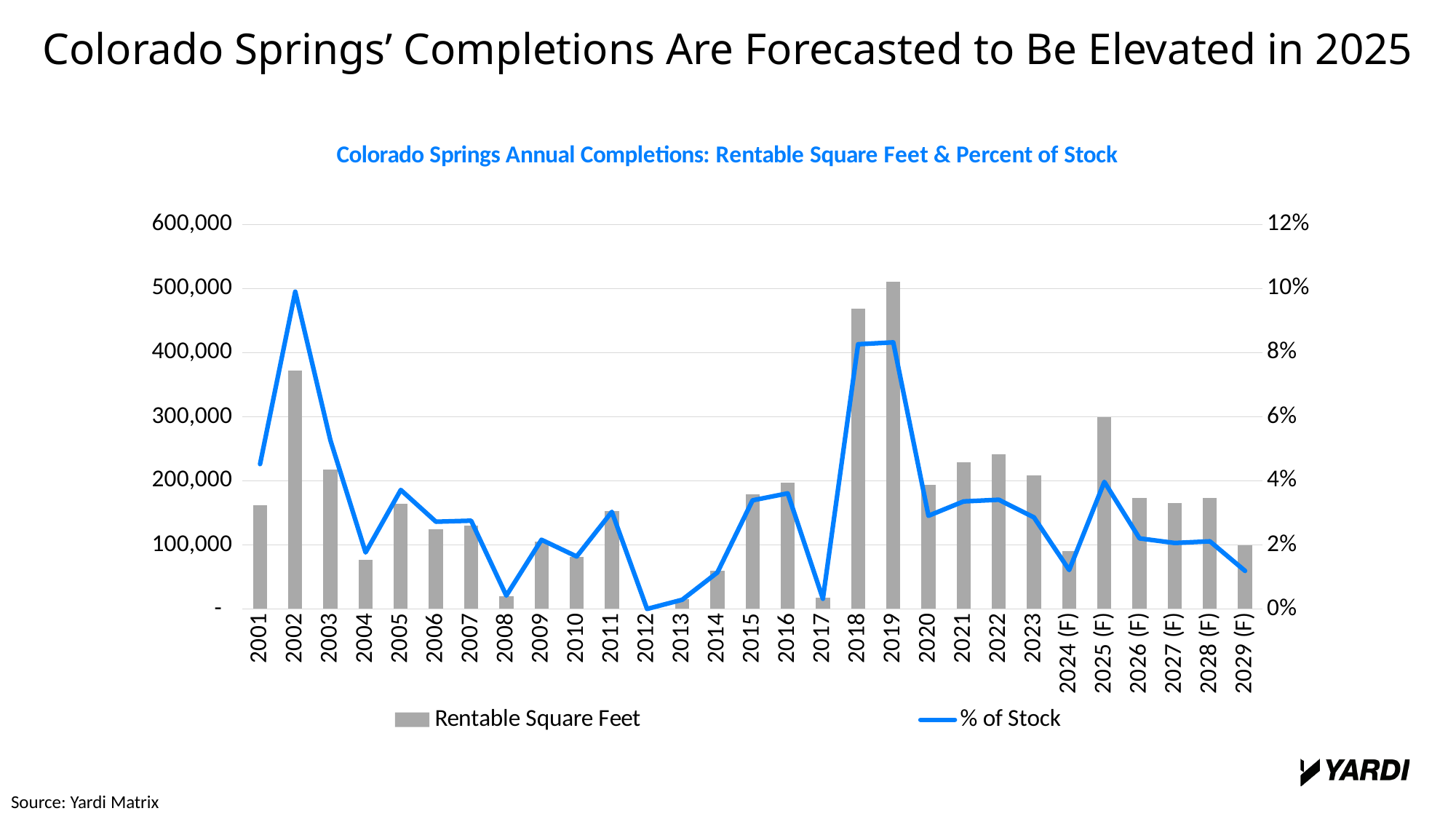
What is the title of the chart? Colorado Springs Annual Completions: Rentable Square Feet & Percent of Stock Which year has the larger Rentable Square Feet bar, 2018 or 2019? 2019 Which year has the highest Rentable Square Feet bar? 2019 What kind of chart is shown on the slide? A combination bar and line chart How many series does the legend list? 2 Is the Rentable Square Feet value for 2019 greater or less than 400,000? greater How many years are shown on the x axis? 29 Is the % of Stock value for 2002 greater or less than 8%? greater Does the Rentable Square Feet value rise or fall from 2024 (F) to 2025 (F)? rise In which year does the % of Stock line reach its highest point? 2002 Which year has the lowest Rentable Square Feet bar? 2012 Is the Rentable Square Feet value for 2024 (F) greater or less than 100,000? less